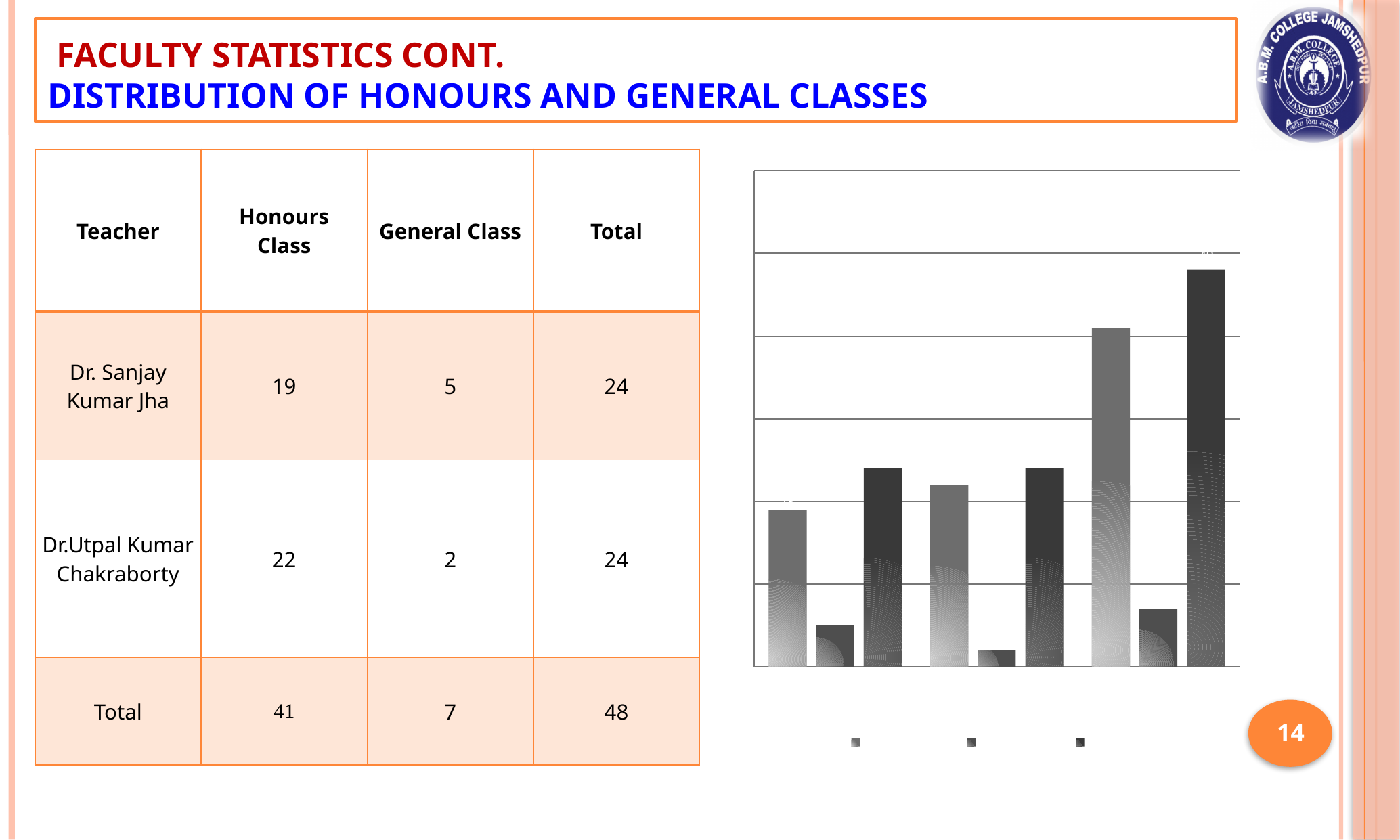
In the chart on the right side of the slide, which group of bars contains the tallest bar: the first, second or third group? third In the chart on the right side of the slide, which group of bars contains the shortest bar: the first, second or third group? second How many legend entries are shown below the chart on the right side of the slide? 3 How many bars are plotted in the chart on the right side of the slide? 9 What kind of chart is shown on the right side of the slide? bar chart In the chart on the right side of the slide, is the tallest bar in the third group taller or shorter than the tallest bar in the first group? taller Are the bars in the chart on the right side of the slide vertical or horizontal? vertical How many groups of bars does the chart on the right side of the slide contain? 3